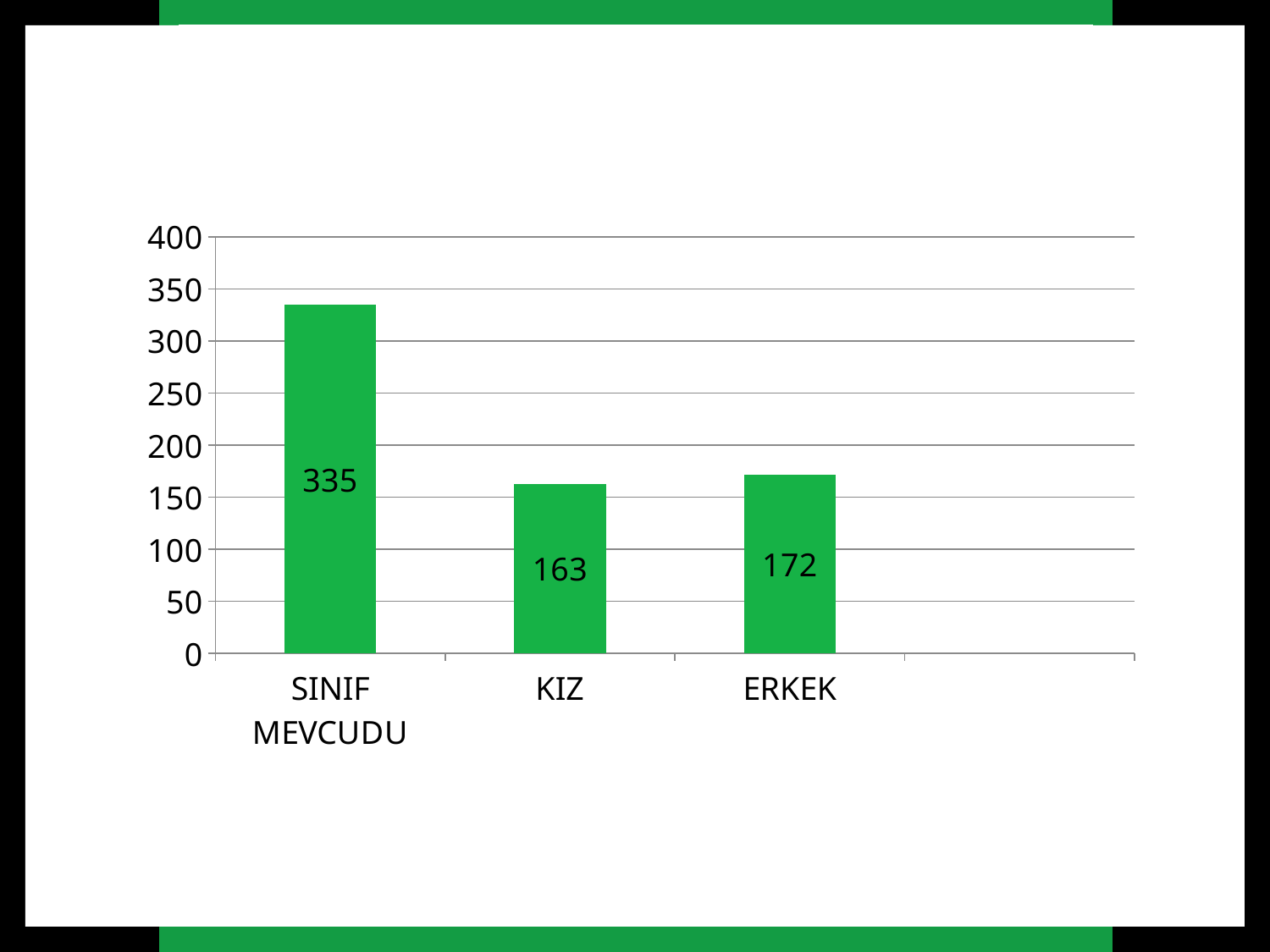
How many categories are shown on the chart? 3 What is the difference between the values for ERKEK and KIZ? 9 What is the value for SINIF MEVCUDU? 335 What is the value for KIZ? 163 Which category has the lowest value? KIZ Is the value for SINIF MEVCUDU greater or less than 300? greater Which category has the highest value? SINIF MEVCUDU Is the value for KIZ greater or less than 200? less Which is larger, the value for KIZ or the value for ERKEK? ERKEK What is the value for ERKEK? 172 What is the difference between the values for SINIF MEVCUDU and ERKEK? 163 What kind of chart is shown on the slide? bar chart